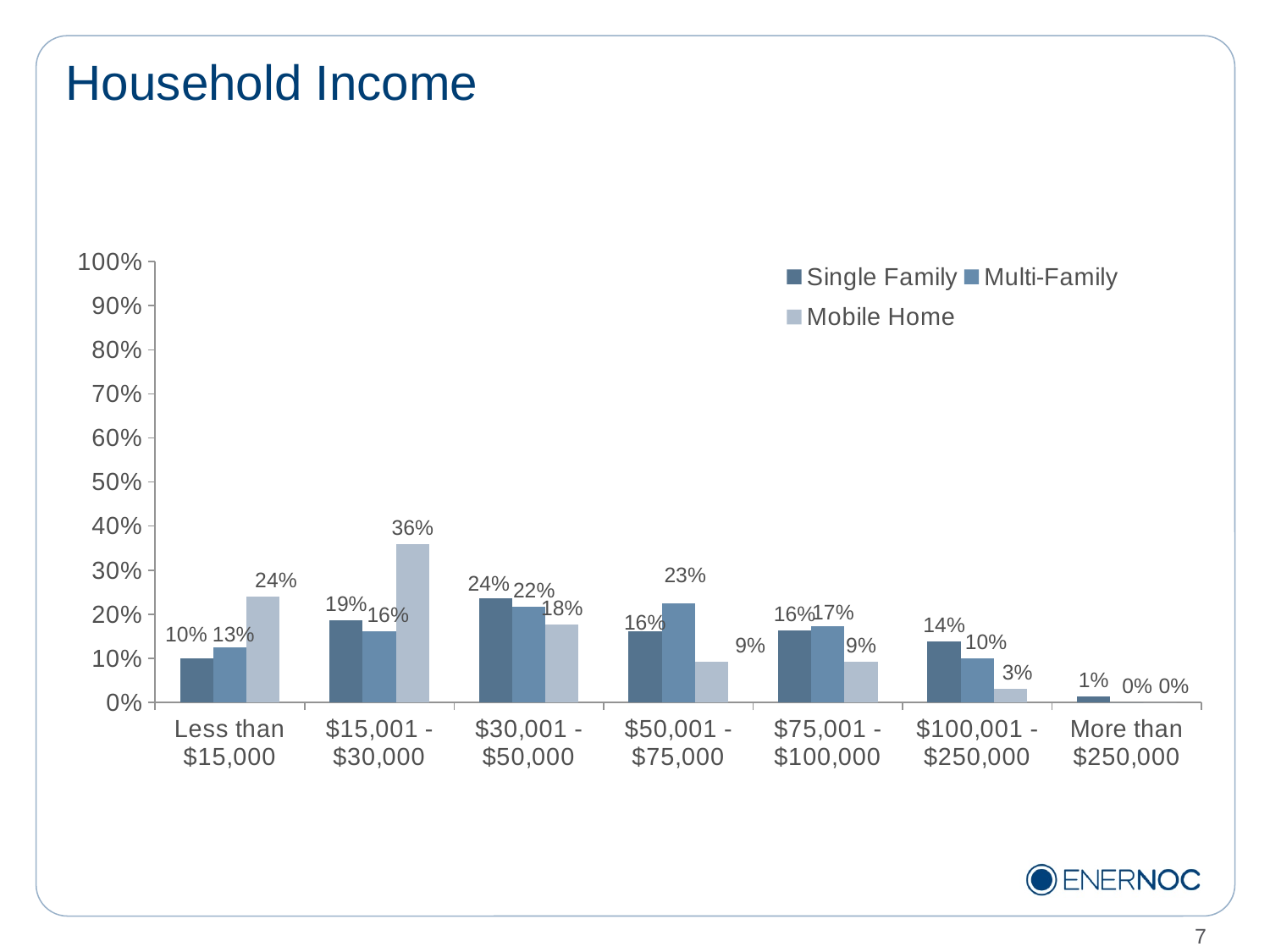
What is the title of the chart? Household Income What is the Mobile Home value for the $15,001 - $30,000 category? 36% What is the Single Family value for the $30,001 - $50,000 category? 24% Which income category has the highest Mobile Home value? $15,001 - $30,000 How many series does the legend list? 3 What is the Multi-Family value for the $50,001 - $75,000 category? 23% How many income categories are shown on the x axis? 7 What kind of chart is shown on the slide? Bar chart In the $100,001 - $250,000 category, which is larger: Single Family or Multi-Family? Single Family Which income category has the lowest Single Family value? More than $250,000 Is the Mobile Home value for the $15,001 - $30,000 category greater or less than 30%? greater What is the difference between the Mobile Home and Single Family values in the Less than $15,000 category? 14%